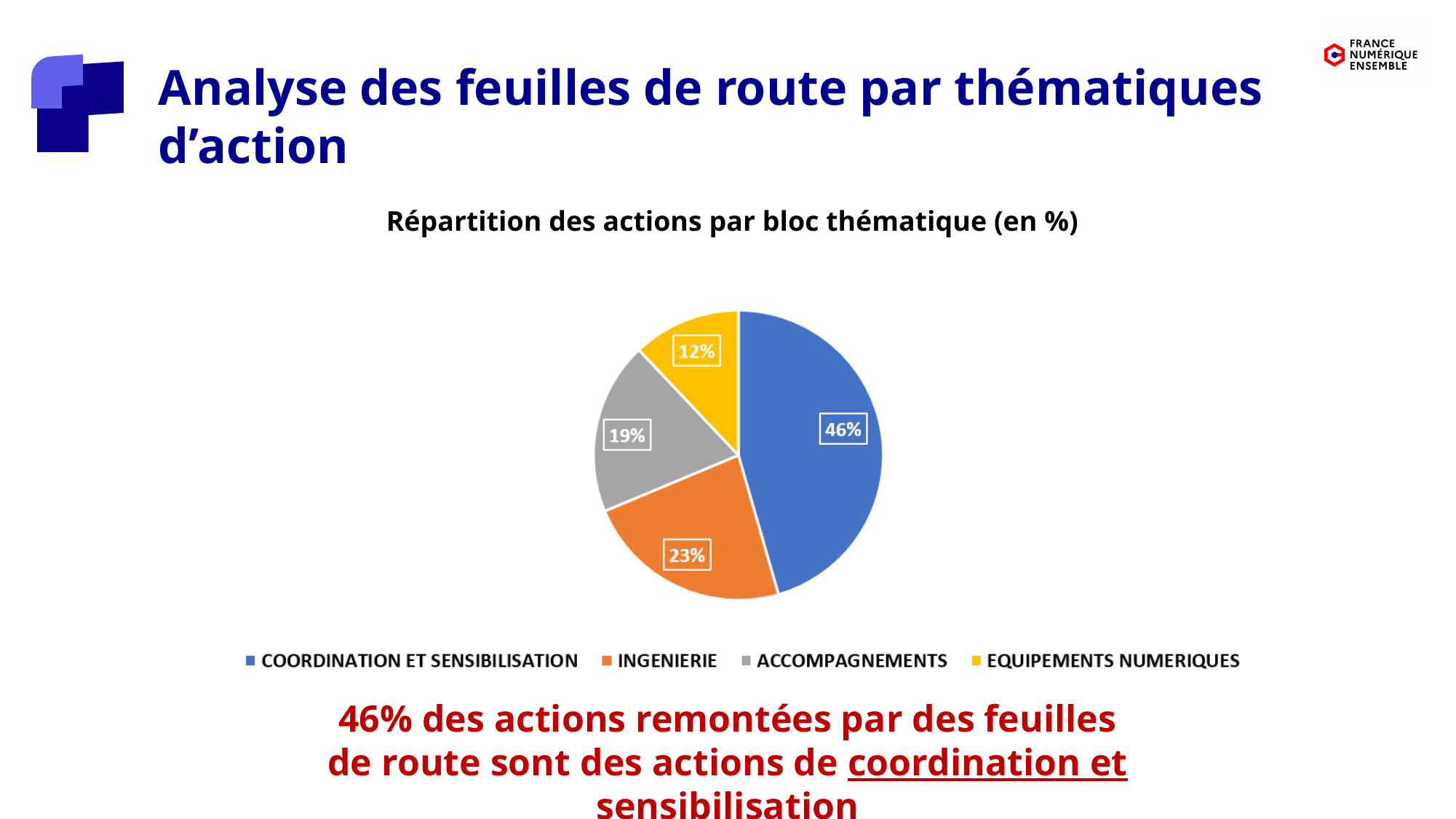
Which category has the largest share of the pie? COORDINATION ET SENSIBILISATION What is the difference in percentage points between COORDINATION ET SENSIBILISATION and INGENIERIE? 23 What share of actions is COORDINATION ET SENSIBILISATION? 46% Which category has the smallest share of the pie? EQUIPEMENTS NUMERIQUES What type of chart is shown on the slide? Pie chart What share of actions is EQUIPEMENTS NUMERIQUES? 12% Which colour represents ACCOMPAGNEMENTS in the pie chart? Grey What share of actions is INGENIERIE? 23% What is the title of the chart? Répartition des actions par bloc thématique (en %) How many categories does the pie chart have? 4 Which is larger, the share for INGENIERIE or the share for ACCOMPAGNEMENTS? INGENIERIE What share of actions is ACCOMPAGNEMENTS? 19%